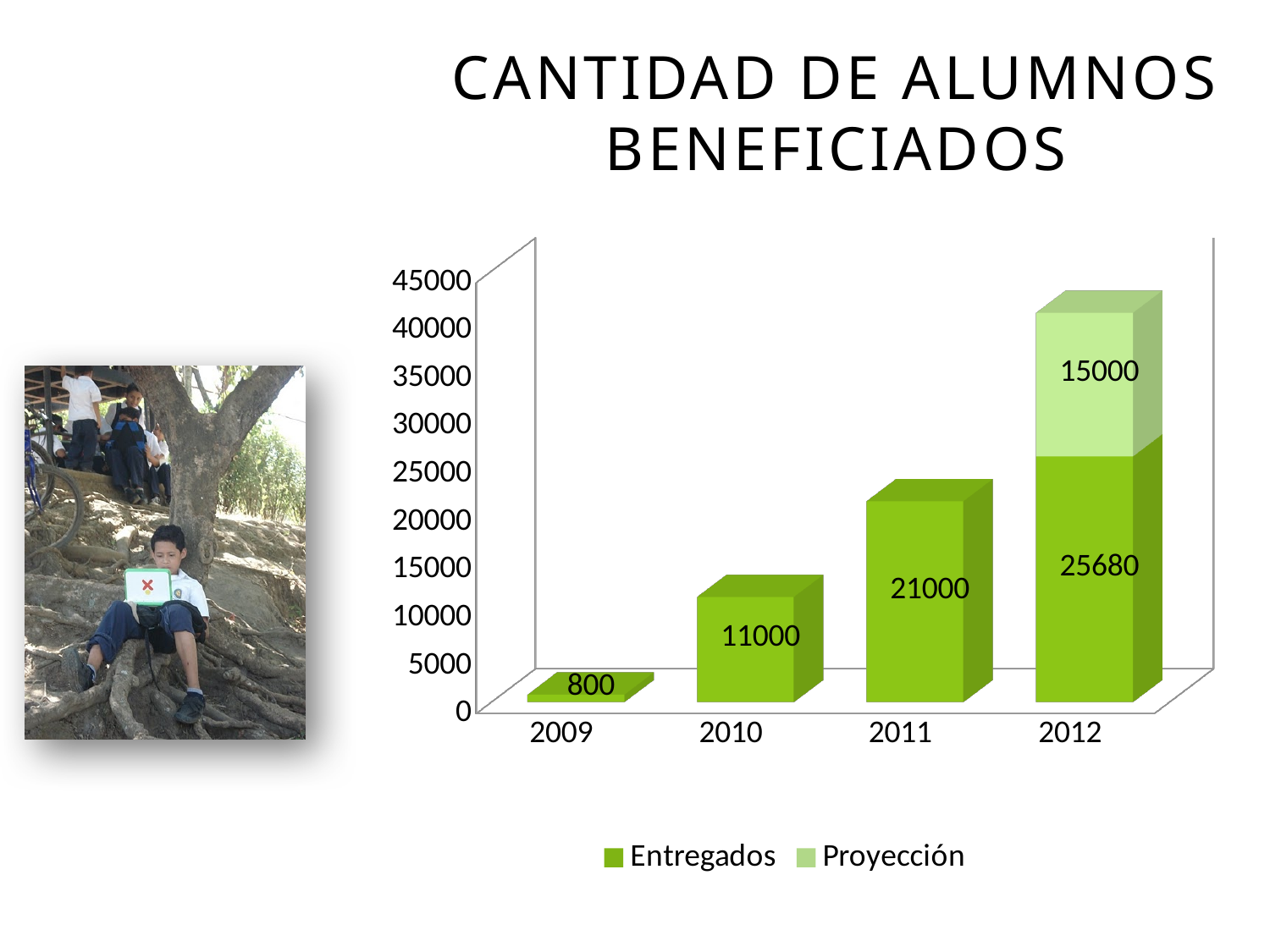
What kind of chart is shown on the slide? bar chart What is the Proyección value for 2012? 15000 How many years are shown on the x axis? 4 Do the Entregados values rise or fall from 2009 to 2012? rise Which year has the highest Entregados value? 2012 What is the Entregados value for 2010? 11000 Which year has the lowest Entregados value? 2009 How many series does the legend list? 2 What is the Entregados value for 2009? 800 What is the total of the stacked bar for 2012? 40680 What is the difference between the Entregados values for 2011 and 2010? 10000 Which is larger, the Entregados value for 2011 or for 2012? 2012